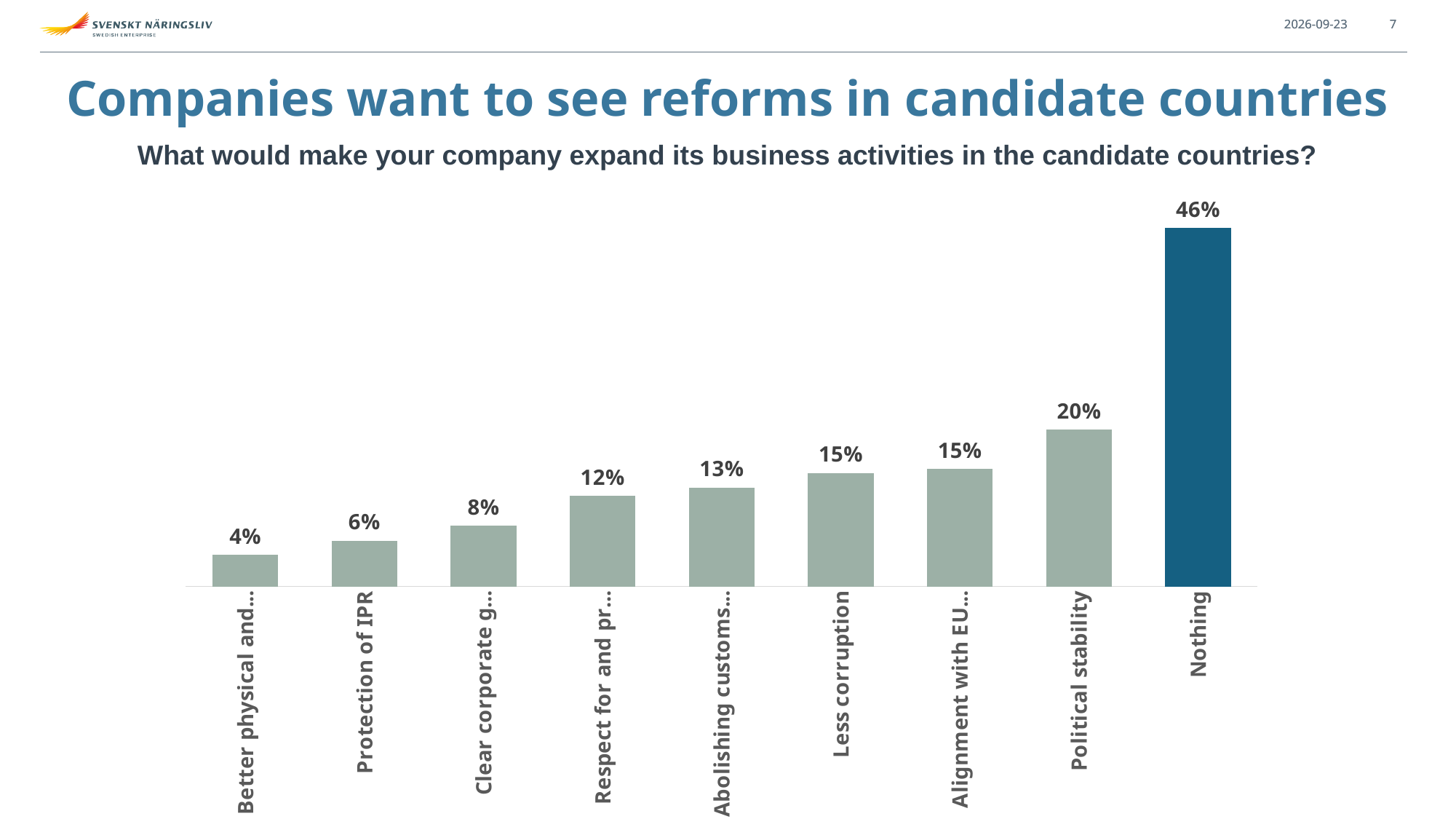
Do the values rise or fall from left to right along the x axis? rise What is the value for Protection of IPR? 6% Which bar is shown in a different colour from the others? Nothing What is the value for Nothing? 46% Which is larger, the value for Less corruption or the value for Protection of IPR? Less corruption Which category has the highest value? Nothing What is the difference between the values for Political stability and Less corruption? 5% How many categories are shown in the chart? 9 What is the value for Political stability? 20% What kind of chart is shown on the slide? bar chart What is the difference between the values for Nothing and Political stability? 26% What is the value for Less corruption? 15%